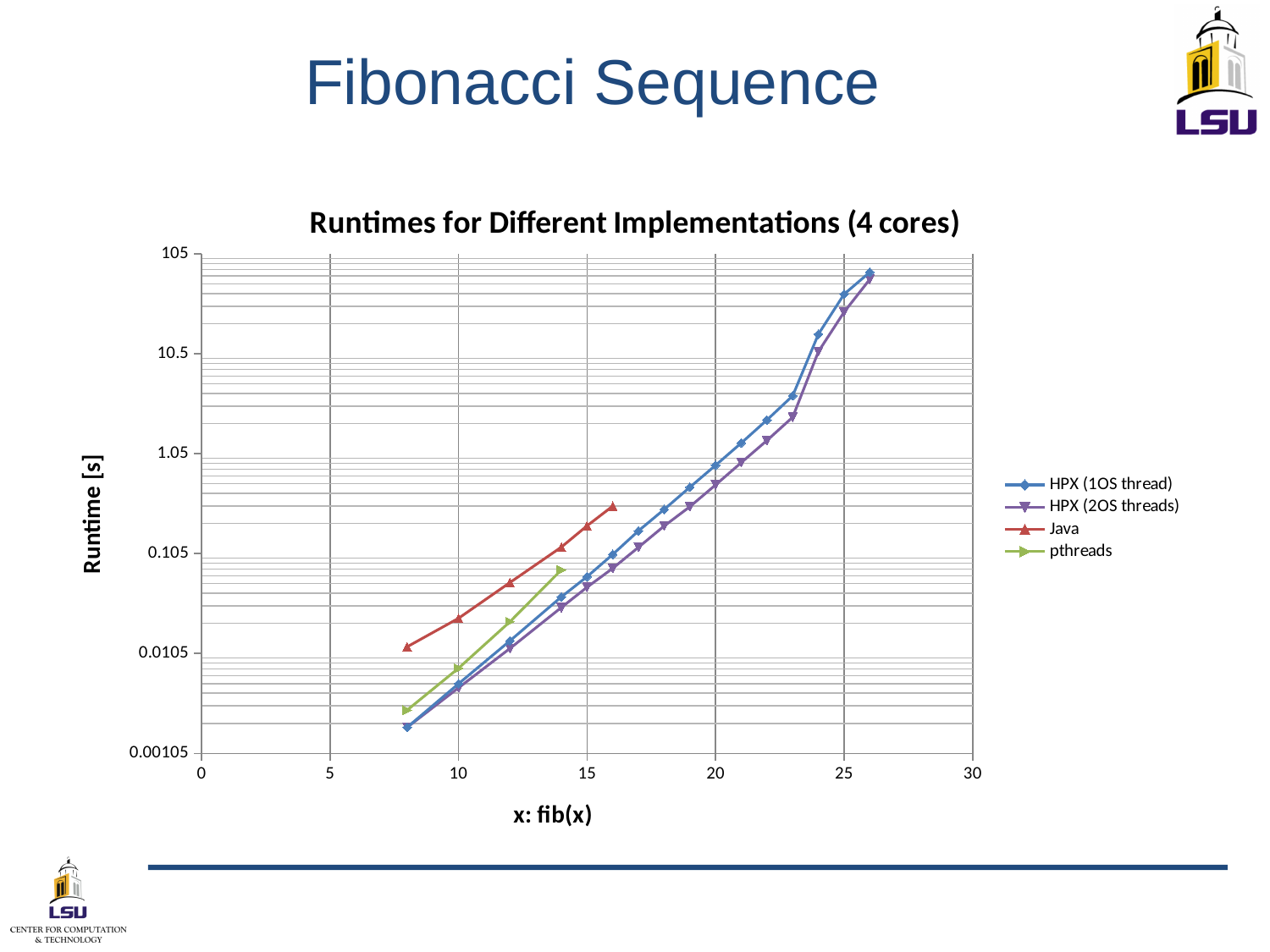
At x = 14, which has the larger runtime, pthreads or HPX (2OS threads)? pthreads Does the runtime for HPX (1OS thread) rise or fall as x increases? Rise What kind of chart is shown on the slide? Line chart Which series has the lowest runtime at x = 12? HPX (2OS threads) What is the label of the y axis? Runtime [s] What is the title of the chart? Runtimes for Different Implementations (4 cores) At x = 12, which has the larger runtime, Java or HPX (1OS thread)? Java How many series does the chart's legend list? 4 Which series has the highest runtime at x = 16? Java Is the runtime for HPX (1OS thread) at x = 26 greater or less than 10.5? greater Is the runtime for Java at x = 16 greater or less than 0.105? greater Is the runtime for pthreads at x = 14 greater or less than 0.105? less